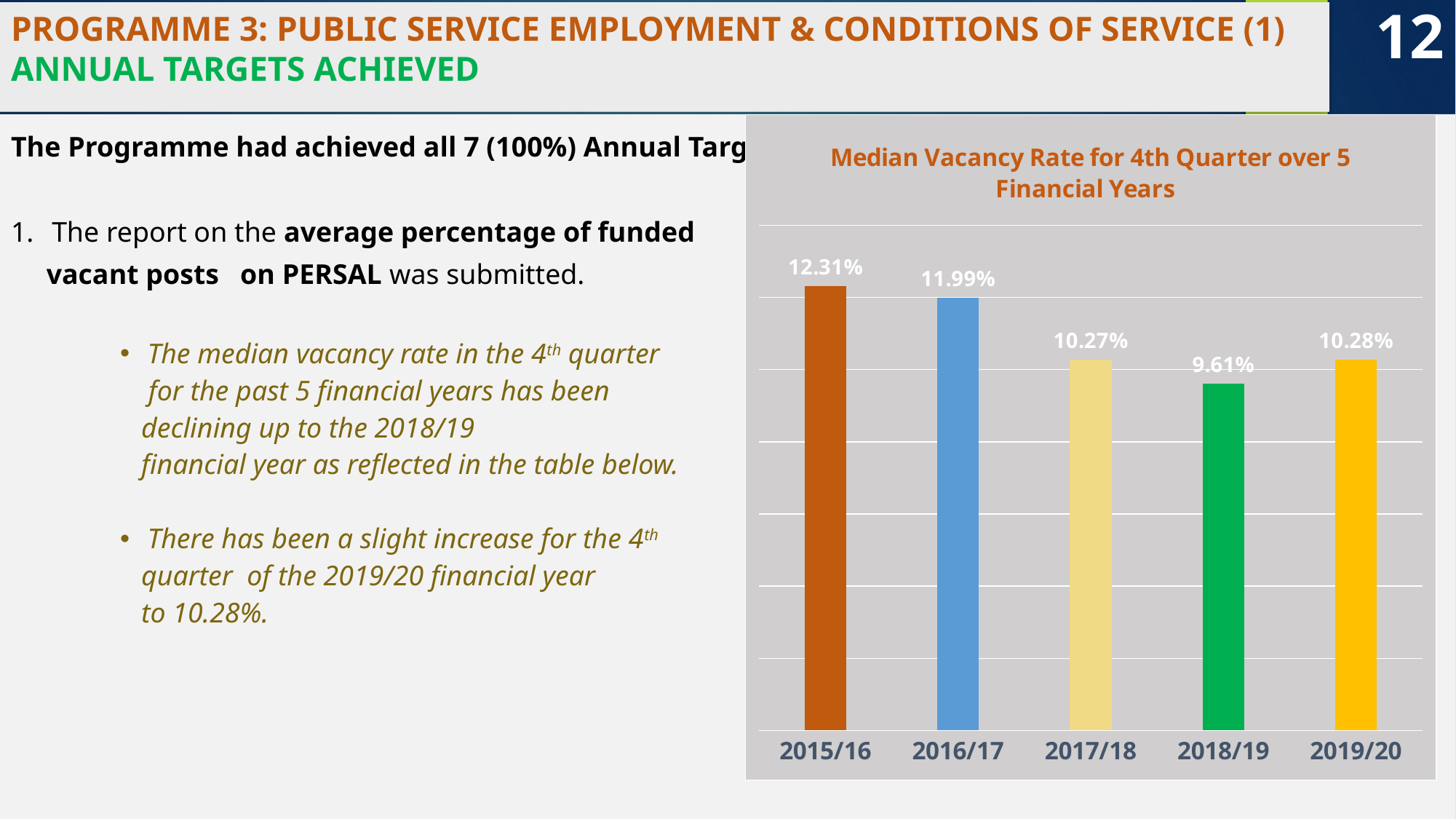
What type of chart is used to show the median vacancy rate? Bar chart What is the difference between the median vacancy rate in 2015/16 and 2018/19? 2.70% Does the median vacancy rate rise or fall from 2015/16 to 2018/19? Fall What is the median vacancy rate for 2018/19? 9.61% Which financial year has the highest median vacancy rate? 2015/16 What is the median vacancy rate for 2015/16? 12.31% What is the median vacancy rate for 2019/20? 10.28% Which financial year has the lowest median vacancy rate? 2018/19 Which is larger, the median vacancy rate for 2016/17 or for 2017/18? 2016/17 What is the median vacancy rate for 2016/17? 11.99% How many financial years are shown in the chart? 5 What is the title of the chart? Median Vacancy Rate for 4th Quarter over 5 Financial Years